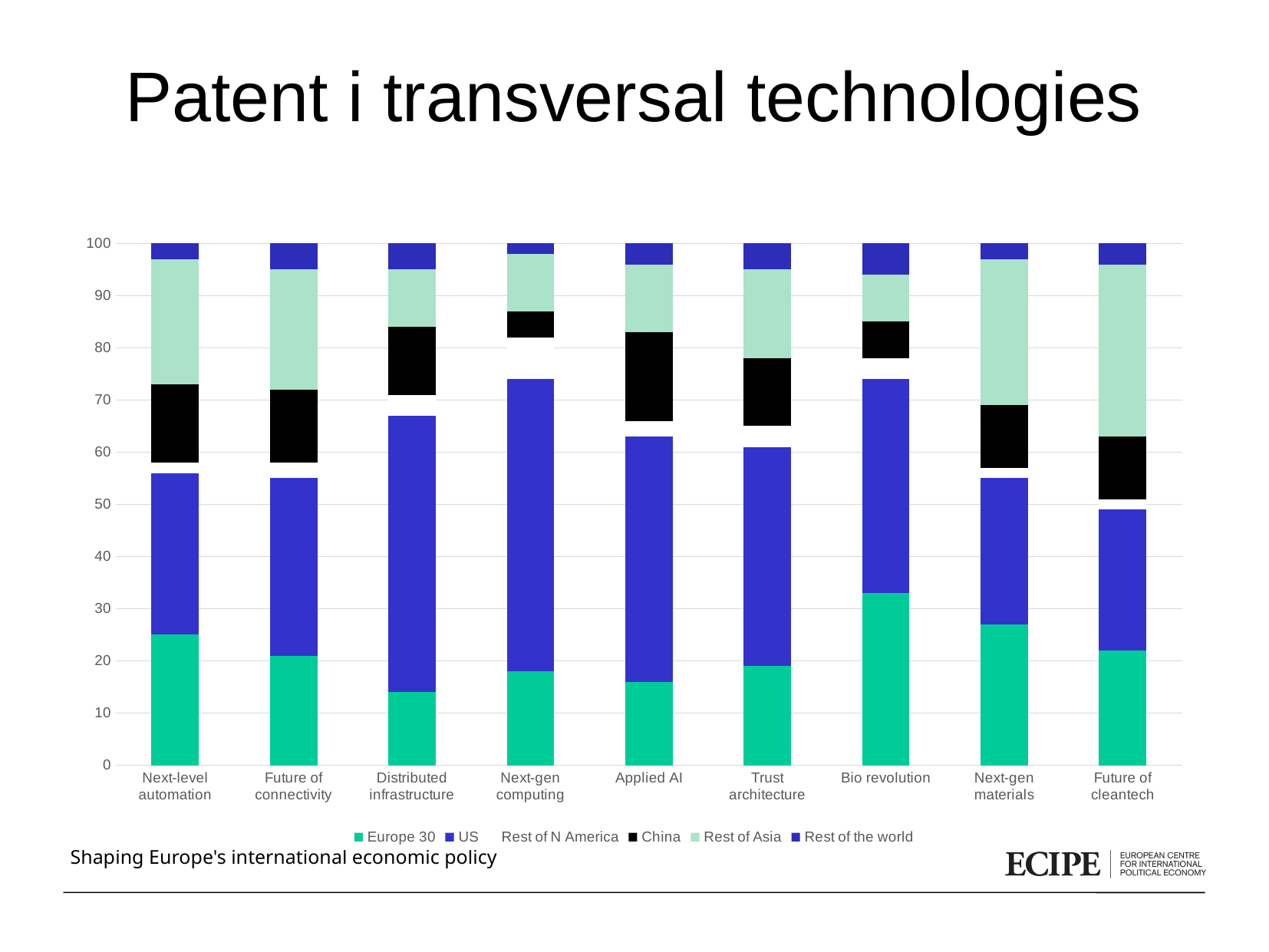
Is the Europe 30 value for Distributed infrastructure greater or less than 20? less Is the Europe 30 value for Next-level automation greater or less than 20? greater How many series does the legend list? 6 Which series is shown at the bottom of each stacked bar? Europe 30 Which category has the largest Europe 30 segment? Bio revolution How many technology categories are shown on the x axis? 9 Which category has the largest Rest of Asia segment? Future of cleantech What kind of chart is shown on the slide? bar chart What is the total height of the stacked bar for Applied AI? 100 Which has a larger Europe 30 segment, Bio revolution or Distributed infrastructure? Bio revolution Is the Europe 30 value for Bio revolution greater or less than 30? greater What is the title of the chart? Patent i transversal technologies